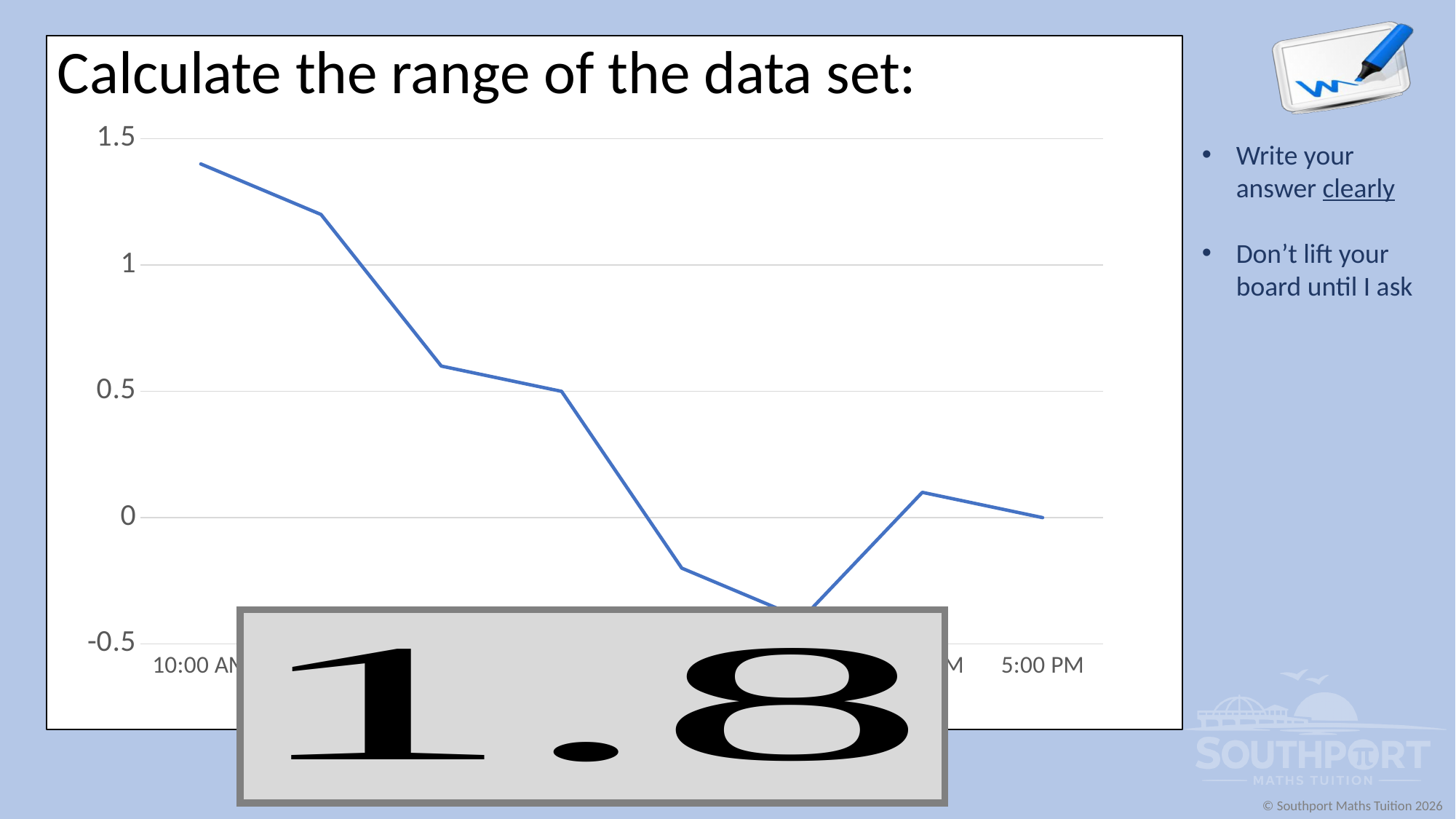
Which is larger, the value at 10:00 AM or the value at 5:00 PM? 10:00 AM How many data points are plotted on the line? 8 What is the title of the slide above the chart? Calculate the range of the data set: What kind of chart is shown on the slide? line chart What answer is displayed in the large box over the chart? 1.8 Which time has the highest value on the chart? 10:00 AM Overall, do the values rise or fall from 10:00 AM to 5:00 PM? fall Is the value at 10:00 AM greater or less than 1? greater What is the value plotted at 5:00 PM? 0 Is the lowest point on the line greater or less than 0? less Is the value at 10:00 AM greater or less than 1.5? less